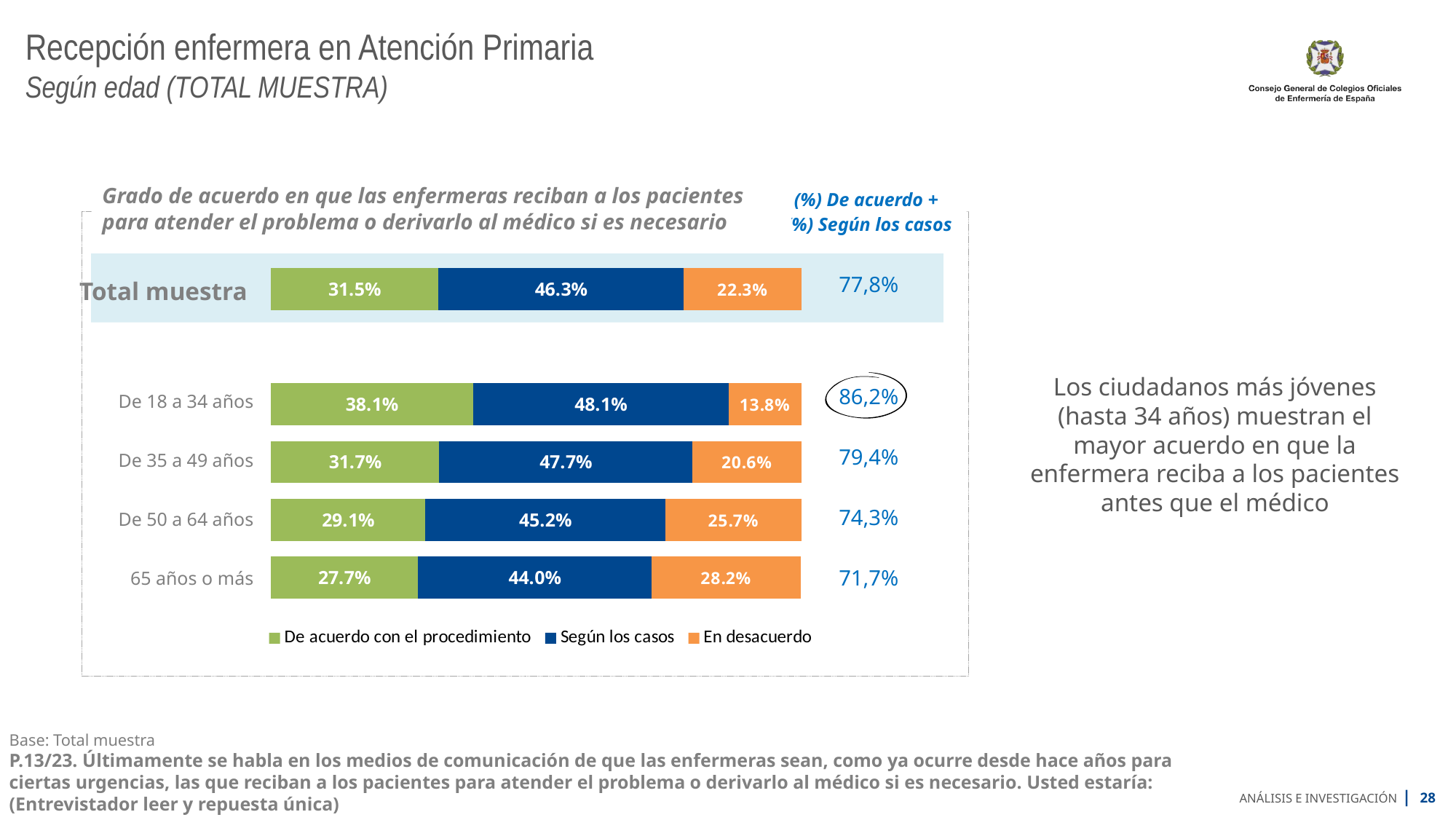
What is the difference between the 'En desacuerdo' values for '65 años o más' and 'De 18 a 34 años'? 14.4% What is the 'En desacuerdo' value for the '65 años o más' group? 28.2% Which colour represents 'En desacuerdo' in the chart? Orange Which age group has the lowest 'En desacuerdo' percentage? De 18 a 34 años What percentage of the 'De 18 a 34 años' group answered 'De acuerdo con el procedimiento'? 38.1% What is the 'Según los casos' value for 'Total muestra'? 46.3% How many series does the legend list? 3 What kind of chart is shown on the slide? Stacked bar chart How many age groups (excluding 'Total muestra') are shown in the chart? 4 Which is larger: the 'Según los casos' value for 'De 35 a 49 años' or for 'De 50 a 64 años'? De 35 a 49 años What is the combined '(%) De acuerdo + (%) Según los casos' figure shown for 'De 50 a 64 años'? 74,3% Which age group has the highest 'De acuerdo con el procedimiento' percentage? De 18 a 34 años